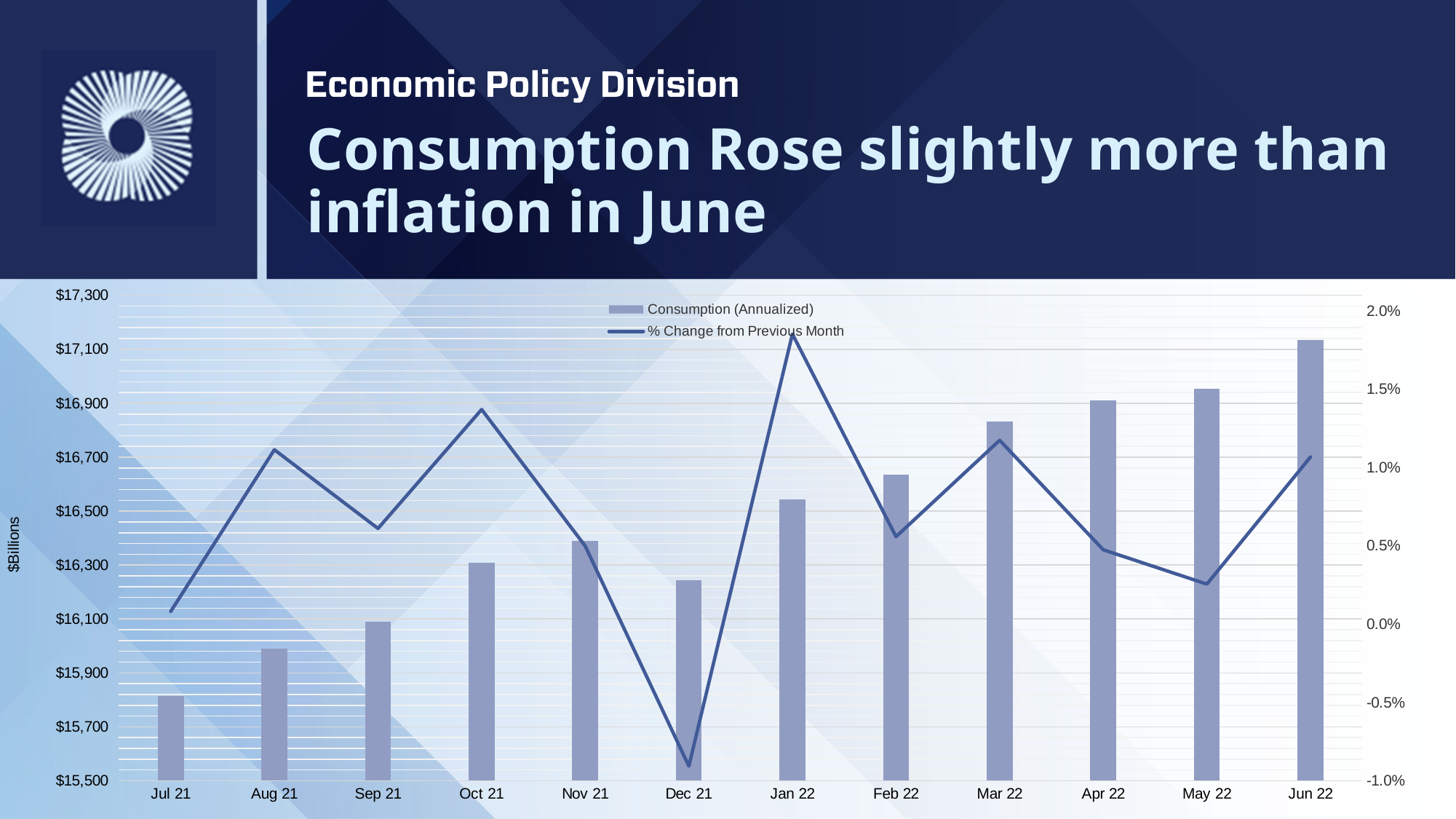
Is the % Change from Previous Month value for Dec 21 greater or less than 0.0%? less In which month does the % Change from Previous Month line reach its lowest point? Dec 21 In which month does the % Change from Previous Month line reach its highest point? Jan 22 Which month has the highest Consumption (Annualized) bar? Jun 22 Which month has the lowest Consumption (Annualized) bar? Jul 21 What is the label on the left vertical axis? $Billions Is the Consumption (Annualized) value for Jul 21 greater or less than $15,900? less How many months are plotted along the x axis? 12 What kind of chart is shown on the slide? A combination bar and line chart How many series does the legend list? 2 Do the Consumption (Annualized) bars generally rise or fall from Jul 21 to Jun 22? rise Which month has the larger Consumption (Annualized) bar, Nov 21 or Dec 21? Nov 21